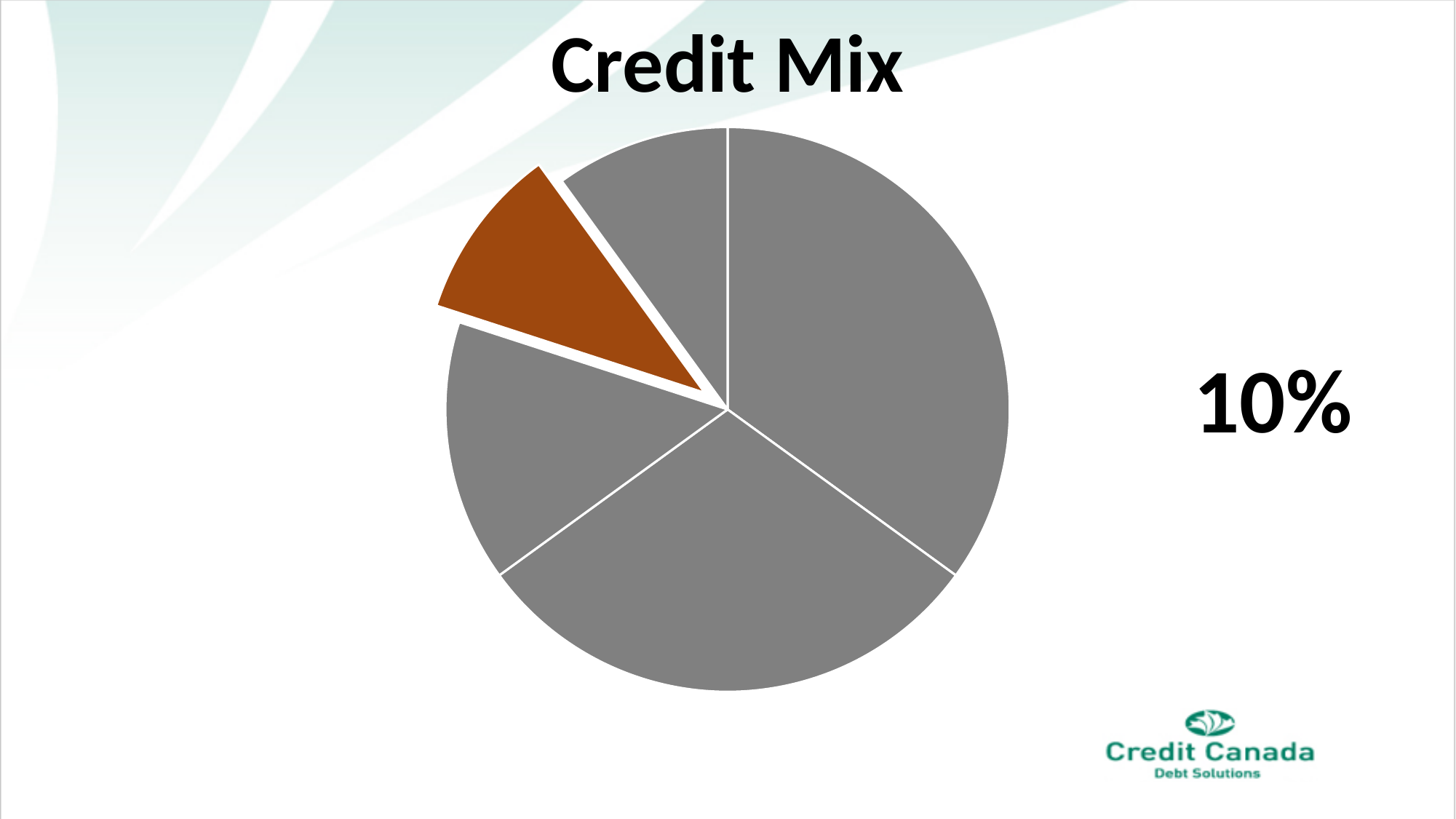
What colour is the exploded slice that is pulled out from the pie? orange What kind of chart is shown on the slide? pie chart What is the title of the chart? Credit Mix How many slices does the pie chart have? 5 Is the share of the large gray slice on the right side of the pie greater or less than 25%? greater Which is larger: the gray slice at the bottom of the pie or the gray slice on the left side? the gray slice at the bottom Is the share of the orange slice greater or less than 25%? less Which is larger: the gray slice on the right side of the pie or the orange slice? the gray slice on the right What share of the pie does the highlighted (orange) slice represent, according to the label on the slide? 10% Is the share of the orange slice greater or less than 50%? less